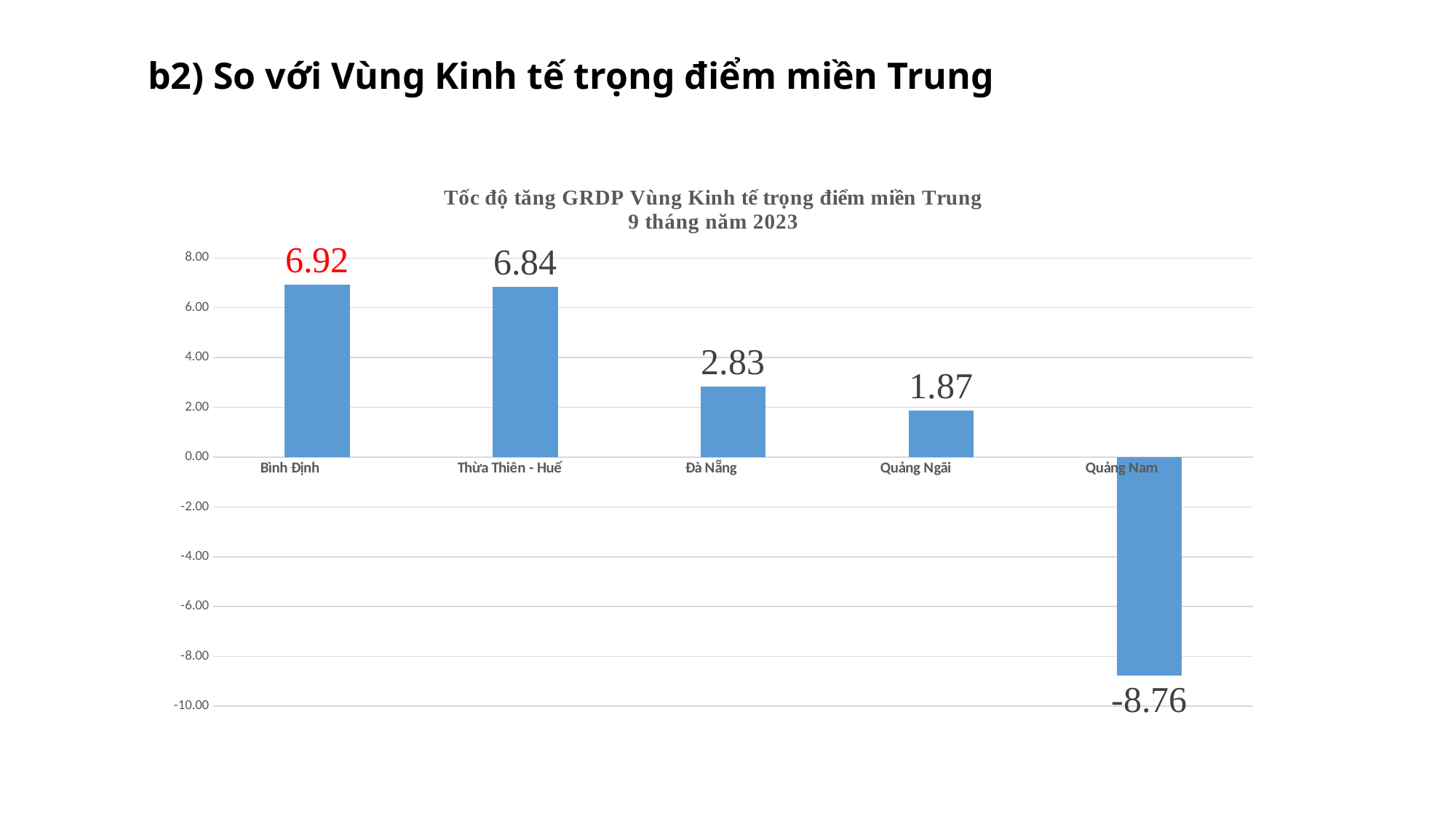
Which province has the highest value? Bình Định What is the value for Quảng Nam? -8.76 Which province has the lowest value? Quảng Nam What is the difference between the values for Đà Nẵng and Quảng Ngãi? 0.96 How many provinces are shown in the chart? 5 What is the value for Đà Nẵng? 2.83 What is the value for Bình Định? 6.92 What is the difference between the values for Bình Định and Thừa Thiên - Huế? 0.08 What kind of chart is shown on the slide? Bar chart Do the values rise or fall from left to right across the chart? Fall What is the title of the chart? Tốc độ tăng GRDP Vùng Kinh tế trọng điểm miền Trung 9 tháng năm 2023 Which is larger, the value for Đà Nẵng or the value for Quảng Ngãi? Đà Nẵng